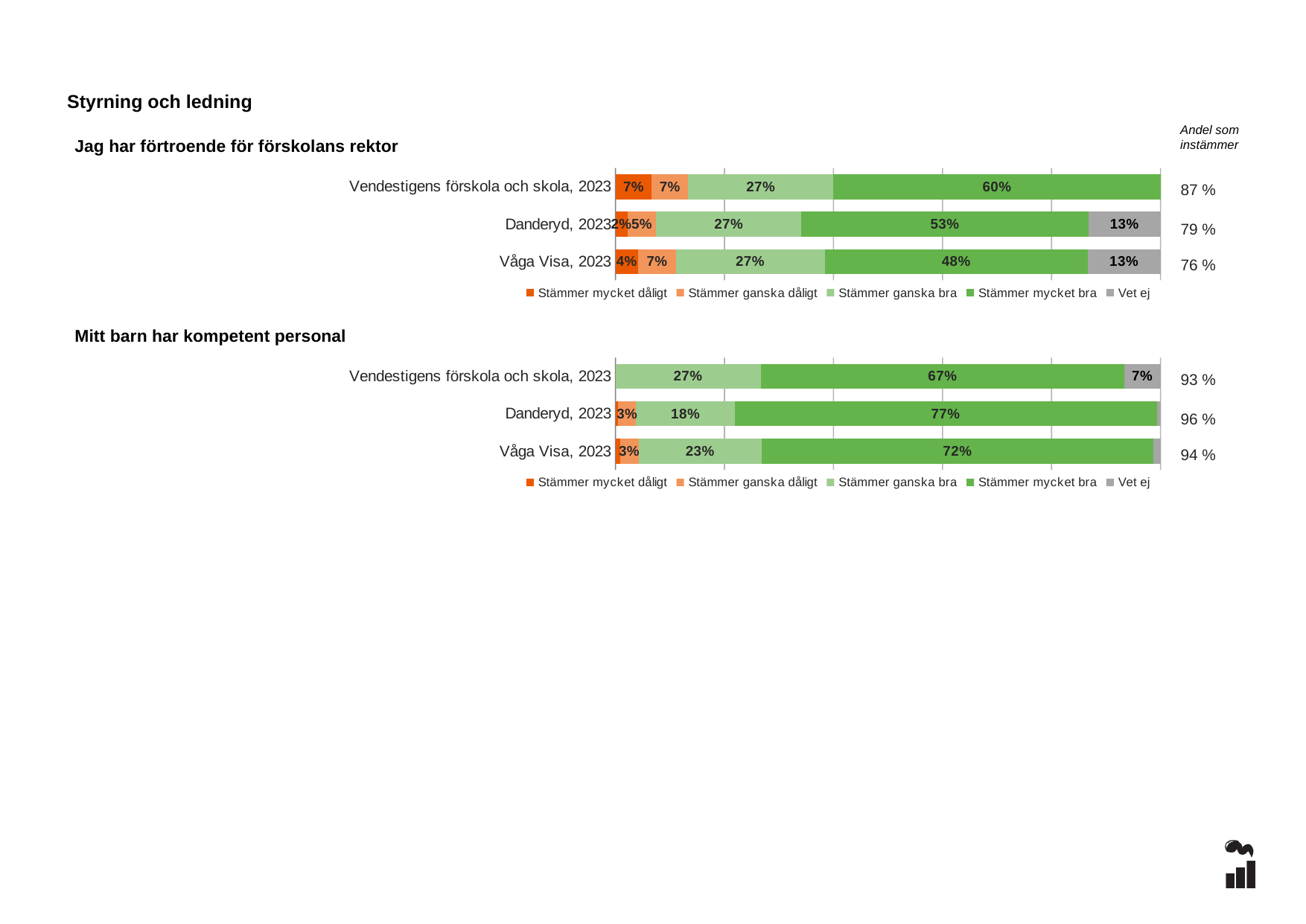
How many categories (bars) does the chart "Mitt barn har kompetent personal" show? 3 In the chart "Jag har förtroende för förskolans rektor", what is the "Vet ej" value for Danderyd, 2023? 13% In the chart "Mitt barn har kompetent personal", which category has the lowest "Stämmer mycket bra" value? Vendestigens förskola och skola, 2023 In the chart "Mitt barn har kompetent personal", is the "Stämmer ganska bra" value larger for Vendestigens förskola och skola, 2023 or for Våga Visa, 2023? Vendestigens förskola och skola, 2023 In the chart "Mitt barn har kompetent personal", what is the "Stämmer mycket bra" value for Danderyd, 2023? 77% In the chart "Jag har förtroende för förskolans rektor", what is the difference between the "Stämmer mycket bra" values for Danderyd, 2023 and Våga Visa, 2023? 5% What kind of chart is "Jag har förtroende för förskolans rektor"? Stacked bar chart In the chart "Jag har förtroende för förskolans rektor", which category has the highest "Stämmer mycket bra" value? Vendestigens förskola och skola, 2023 In the chart "Mitt barn har kompetent personal", what is the "Andel som instämmer" value shown for Danderyd, 2023? 96 % In the chart "Jag har förtroende för förskolans rektor", what is the "Andel som instämmer" value shown for Våga Visa, 2023? 76 % In the chart "Jag har förtroende för förskolans rektor", what is the "Stämmer mycket bra" value for Vendestigens förskola och skola, 2023? 60% How many series does the legend of the chart "Jag har förtroende för förskolans rektor" list? 5